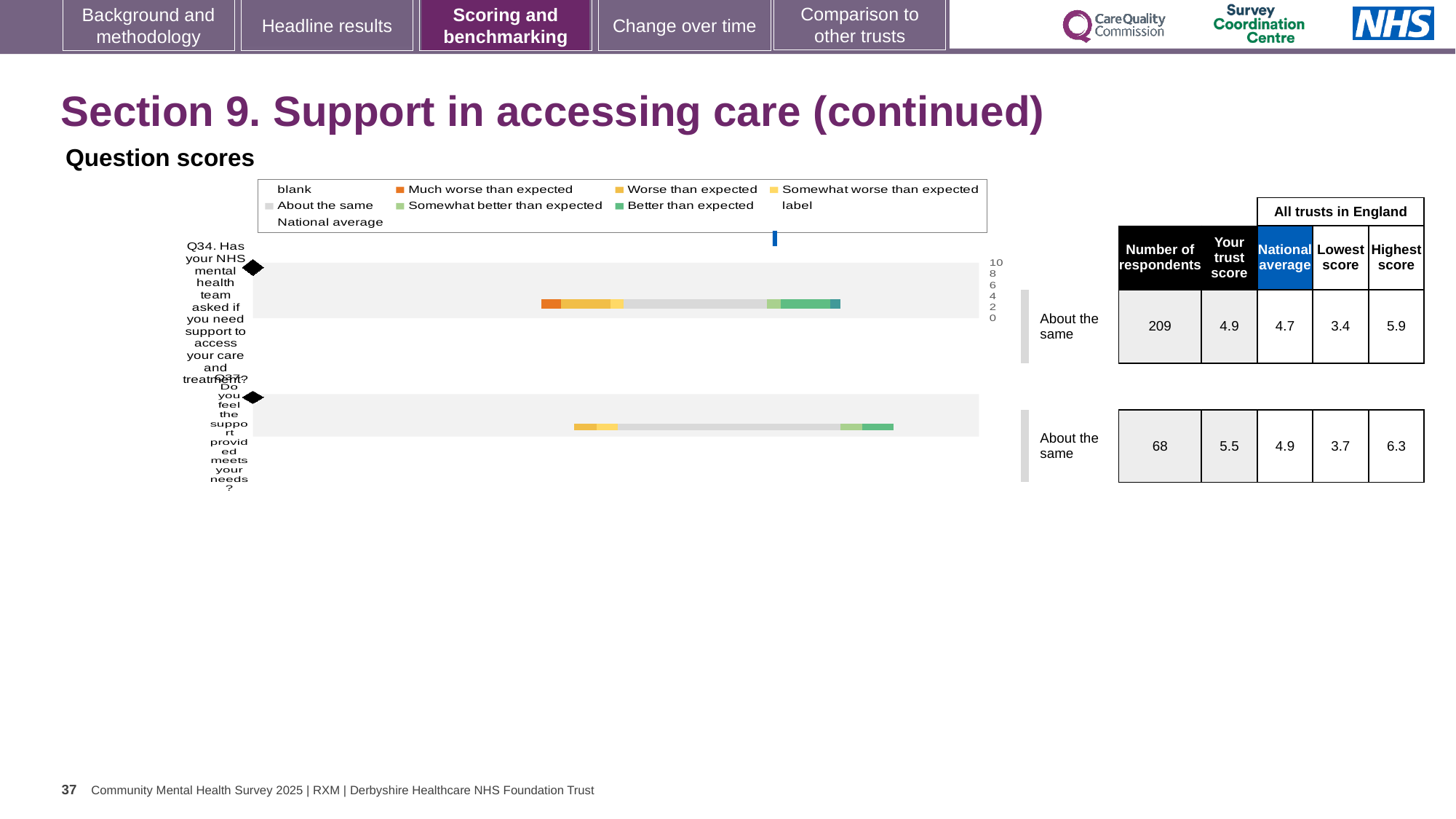
What is the heading above the question scores chart? Question scores What kind of chart is used to show the question scores on this slide? bar chart What is the highest score among all trusts in England for Q37? 6.3 How many entries does the legend of the question scores chart list? 9 How many respondents answered Q34? 209 What is the difference between the trust score for Q37 (5.5) and the trust score for Q34 (4.9)? 0.6 How many questions (categories) are plotted in the question scores chart? 2 What is the benchmark category shown for Q34 in the question scores chart? About the same What is the trust score for Q34 (Has your NHS mental health team asked if you need support to access your care and treatment?)? 4.9 What is the national average score for Q37 (Do you feel the support provided meets your needs?)? 4.9 In the question scores chart legend, which colour represents 'Much worse than expected'? orange Which question has the higher trust score, Q34 or Q37? Q37